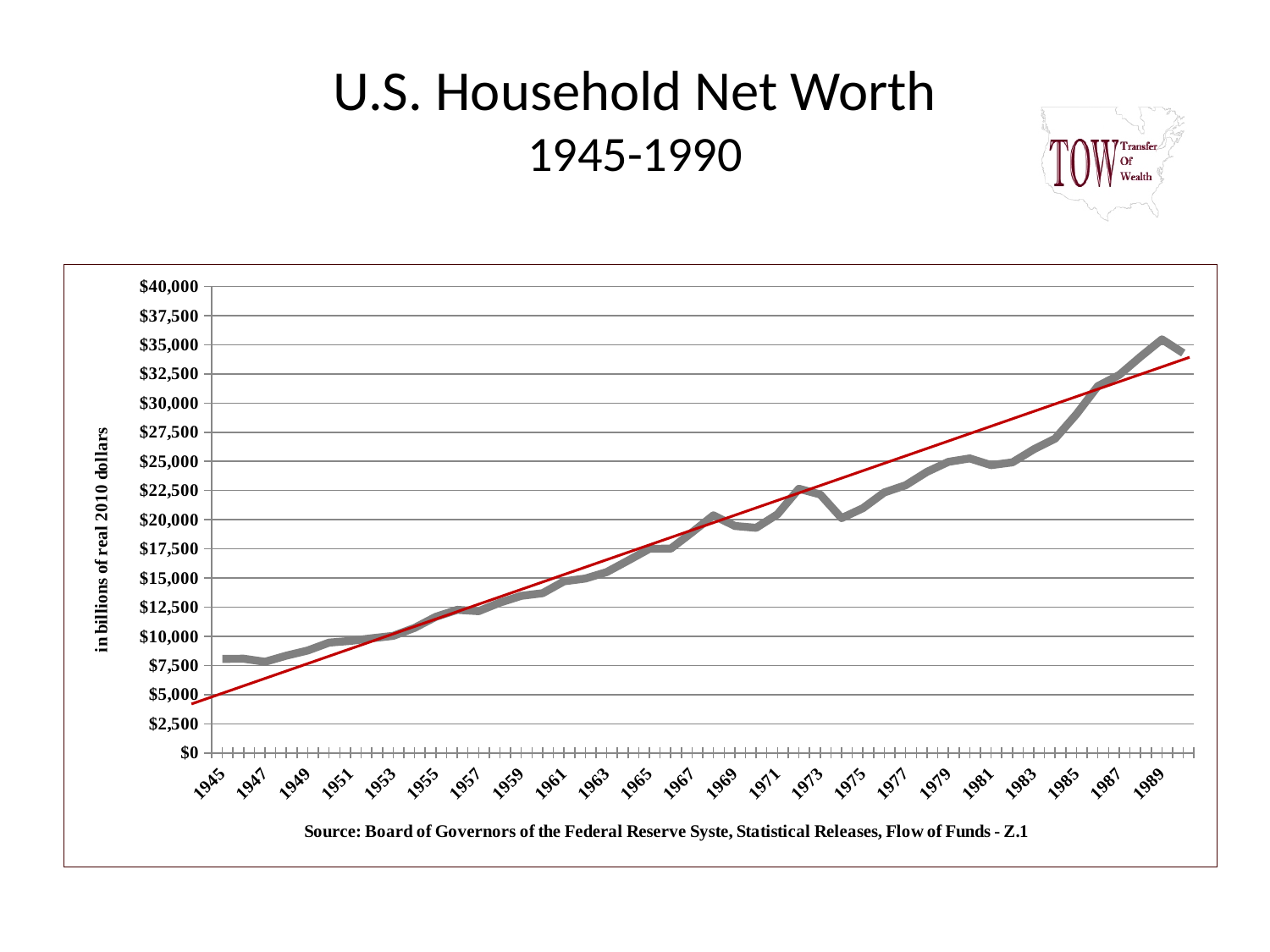
Is the value for 1989 greater or less than $30,000? greater Do the values of U.S. household net worth generally rise or fall from 1945 to 1990? rise Is the value for 1945 greater or less than $10,000? less Is the value for 1981 greater or less than $27,500? less Which year has the highest household net worth on the chart? 1989 What kind of chart is shown on the slide? line chart Which is larger, the value for 1973 or the value for 1975? 1973 What is the label on the vertical axis of the chart? in billions of real 2010 dollars What is the title of the chart on the slide? U.S. Household Net Worth 1945-1990